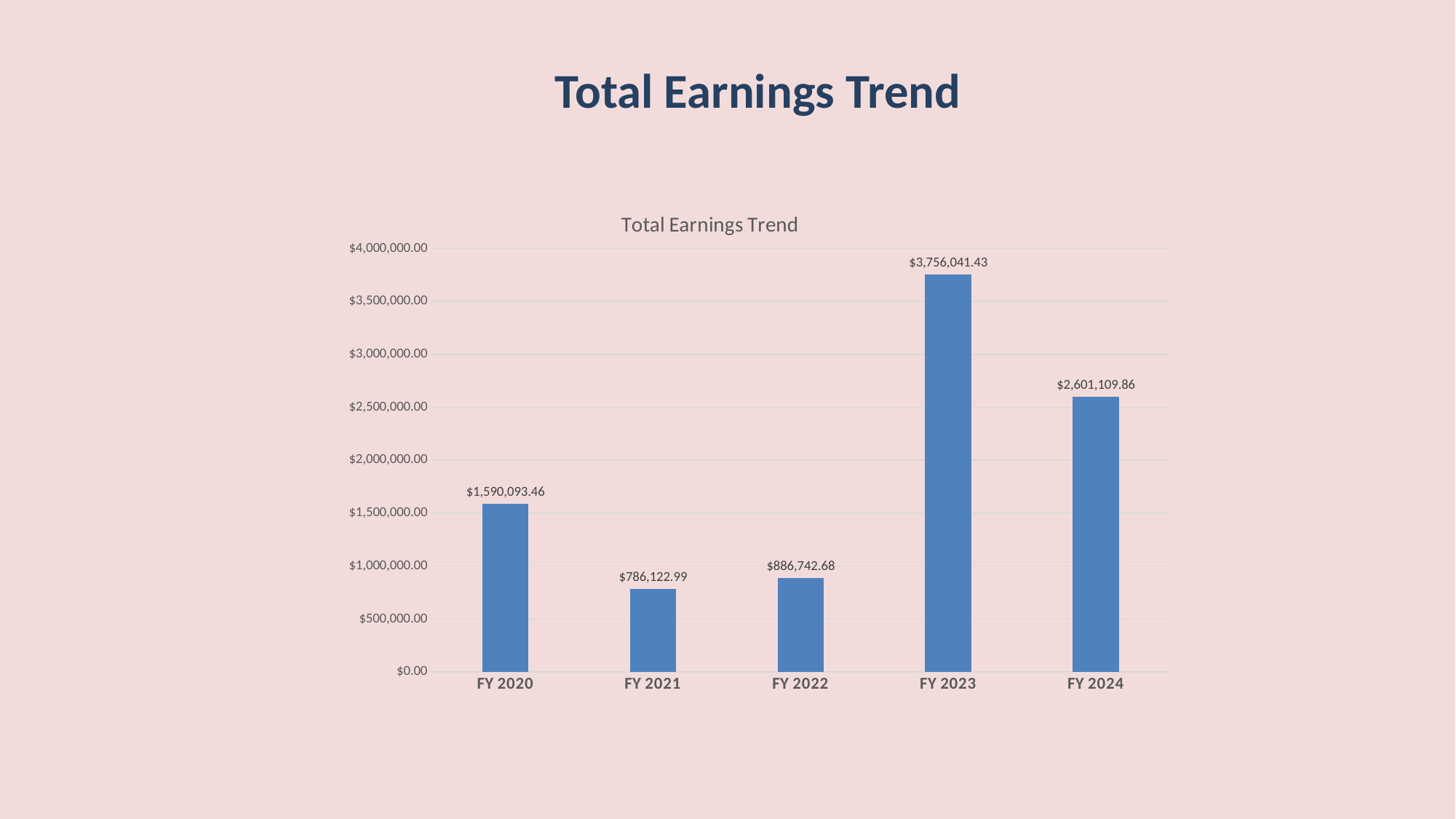
Which fiscal year has the highest total earnings? FY 2023 What is the difference between the values for FY 2023 and FY 2024? $1,154,931.57 Which fiscal year has the lowest total earnings? FY 2021 What is the value for FY 2024? $2,601,109.86 What kind of chart is shown on the slide? bar chart Is the value for FY 2024 greater or less than $2,500,000.00? greater What is the value for FY 2021? $786,122.99 Does the value rise or fall from FY 2023 to FY 2024? fall What is the difference between the values for FY 2022 and FY 2021? $100,619.69 Which is larger, the value for FY 2020 or the value for FY 2022? FY 2020 How many fiscal years are shown on the chart? 5 What is the value for FY 2023? $3,756,041.43